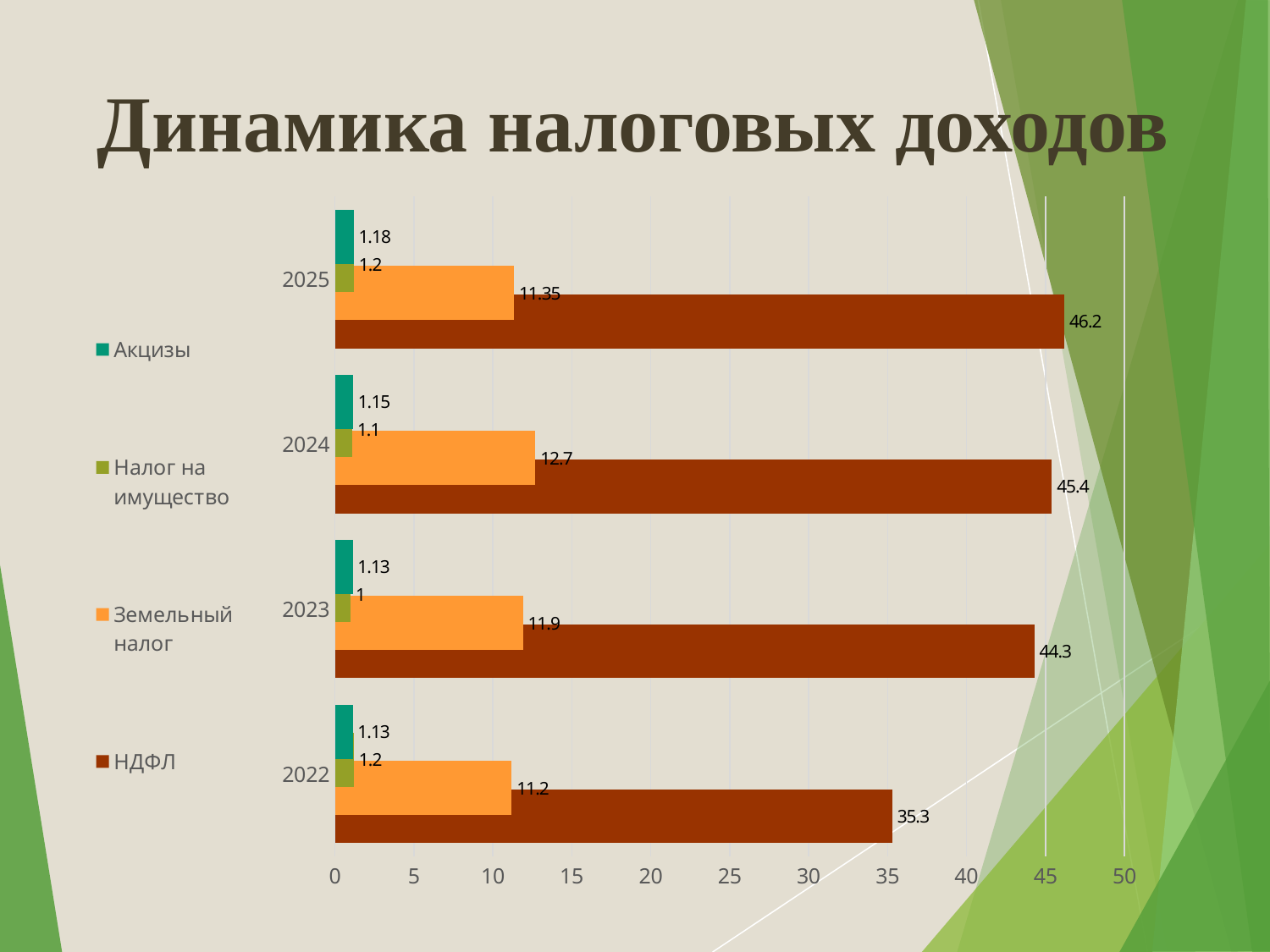
What is the value of НДФЛ for 2025? 46.2 In which year is НДФЛ the highest? 2025 How many years are shown on the chart? 4 What is the value of Акцизы for 2022? 1.13 In which year is НДФЛ the lowest? 2022 What is the difference between НДФЛ in 2025 and НДФЛ in 2022? 10.9 Which is larger: Земельный налог in 2024 or Земельный налог in 2023? Земельный налог in 2024 What type of chart is shown on the slide? bar chart What is the value of Налог на имущество for 2023? 1 What is the value of Земельный налог for 2024? 12.7 Is the value of НДФЛ for 2024 greater or less than 40? greater How many series does the legend list? 4